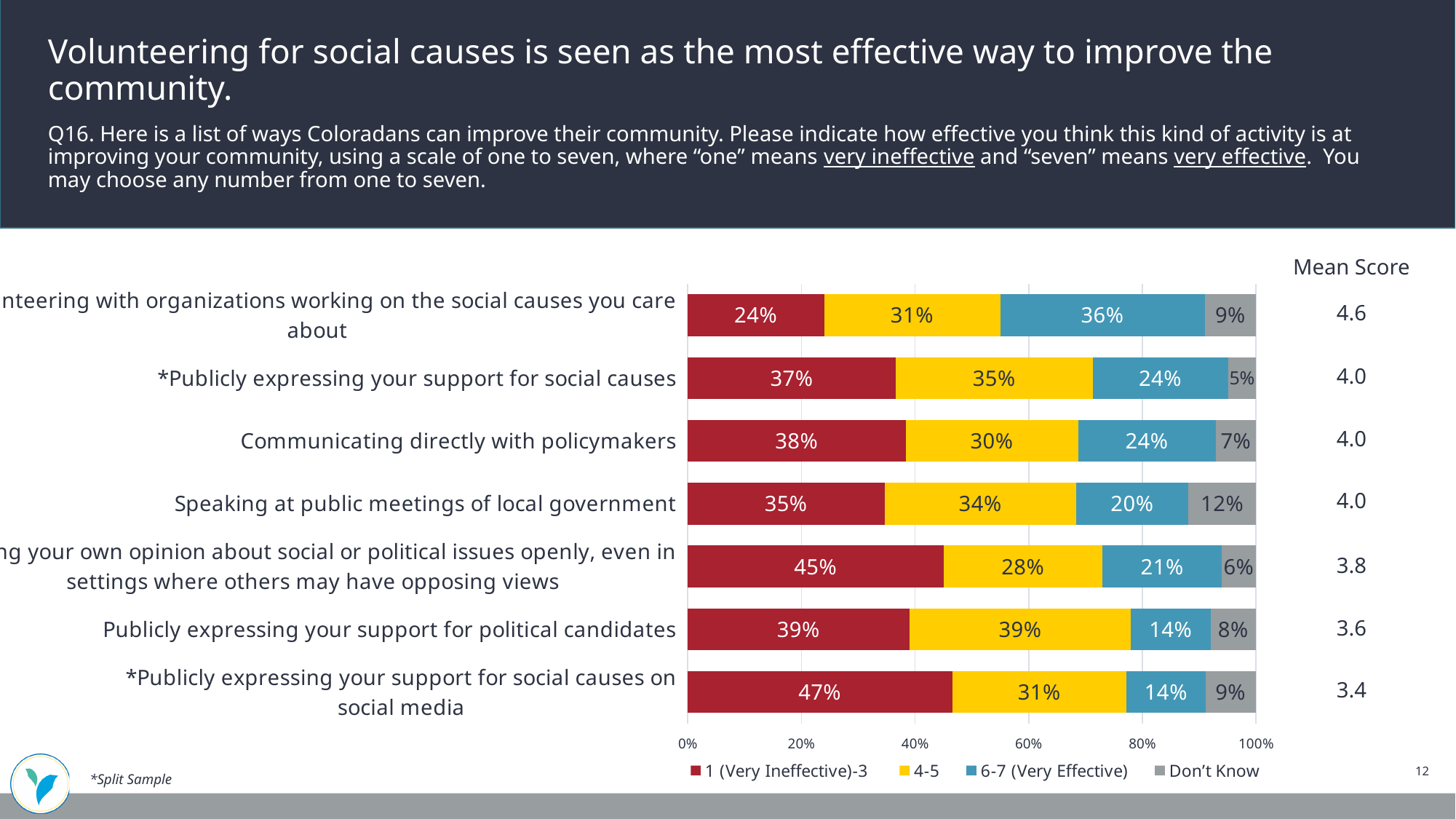
How many series does the legend list? 4 How many activities (bars) are shown in the chart? 7 What percentage of respondents rated "Communicating directly with policymakers" as 1 (Very Ineffective)-3? 38% What percentage rated "Publicly expressing your support for political candidates" as 6-7 (Very Effective)? 14% What kind of chart is shown on the slide? Stacked bar chart For "Communicating directly with policymakers", how many percentage points larger is the 1 (Very Ineffective)-3 share than the 6-7 (Very Effective) share? 14 percentage points Which activity has the lowest Don't Know percentage? *Publicly expressing your support for social causes Which has a larger 4-5 share: "Speaking at public meetings of local government" or "Communicating directly with policymakers"? Speaking at public meetings of local government What is the Don't Know percentage for "Speaking at public meetings of local government"? 12% Which activity has the highest share of 1 (Very Ineffective)-3 ratings? *Publicly expressing your support for social causes on social media What is the total of the stacked bar for "Publicly expressing your support for political candidates"? 100% What is the Mean Score for "*Publicly expressing your support for social causes on social media"? 3.4